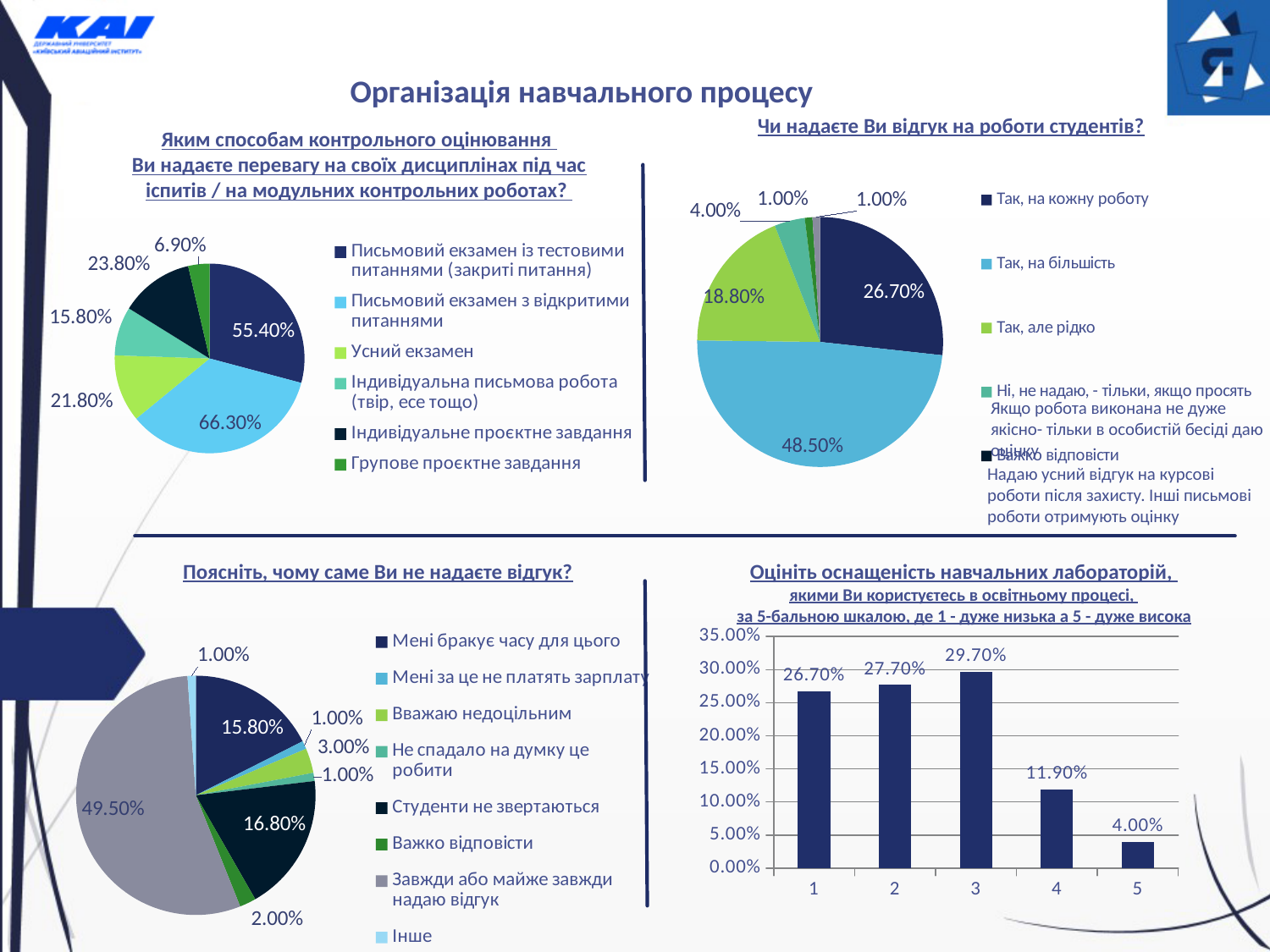
In the top-left pie chart about preferred assessment methods, which is larger: 'Індивідуальне проєктне завдання' or 'Групове проєктне завдання'? Індивідуальне проєктне завдання In the pie chart 'Поясніть, чому саме Ви не надаєте відгук?', what is the value for 'Завжди або майже завжди надаю відгук'? 49.50% What type of chart is the bottom-right chart 'Оцініть оснащеність навчальних лабораторій'? bar chart In the bar chart 'Оцініть оснащеність навчальних лабораторій', how many categories are shown on the x axis? 5 In the pie chart 'Чи надаєте Ви відгук на роботи студентів?', which is larger: 'Так, на кожну роботу' or 'Так, але рідко'? Так, на кожну роботу In the bar chart 'Оцініть оснащеність навчальних лабораторій', which category has the lowest value? 5 In the pie chart 'Чи надаєте Ви відгук на роботи студентів?', what is the value for 'Так, на більшість'? 48.50% In the bar chart 'Оцініть оснащеність навчальних лабораторій', what is the difference between the values for category 3 and category 4? 17.80% In the top-left pie chart about preferred assessment methods, what is the value for 'Усний екзамен'? 21.80% In the bar chart 'Оцініть оснащеність навчальних лабораторій', which category has the highest value? 3 In the bar chart 'Оцініть оснащеність навчальних лабораторій', what is the value for category 3? 29.70% In the pie chart 'Поясніть, чому саме Ви не надаєте відгук?', how many entries does the legend list? 8